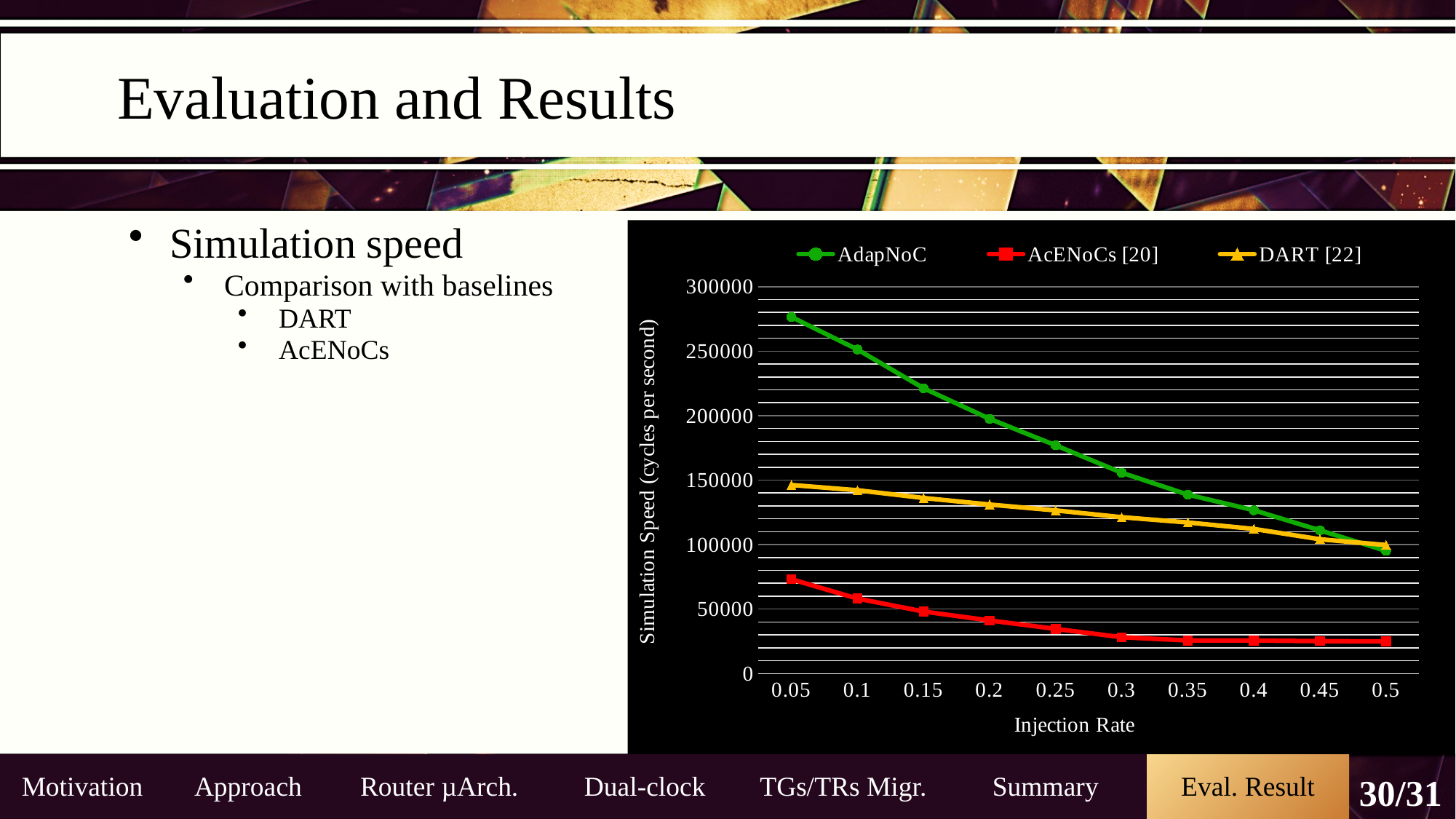
How many series does the chart's legend list? 3 Which series has the highest simulation speed at injection rate 0.1? AdapNoC Which series has the lowest simulation speed at injection rate 0.3? AcENoCs [20] Is the simulation speed of DART [22] at injection rate 0.3 greater or less than 100000? greater Is the simulation speed of AdapNoC at injection rate 0.05 greater or less than 250000? greater What is the title of the chart's x axis? Injection Rate What is the title of the chart's y axis? Simulation Speed (cycles per second) Is the simulation speed of AcENoCs [20] at injection rate 0.05 greater or less than 100000? less How many injection rate values are plotted along the x axis? 10 Does the simulation speed of AdapNoC rise or fall as the injection rate increases? fall What kind of chart is shown on the slide? line chart At injection rate 0.2, which has the higher simulation speed, AdapNoC or DART [22]? AdapNoC